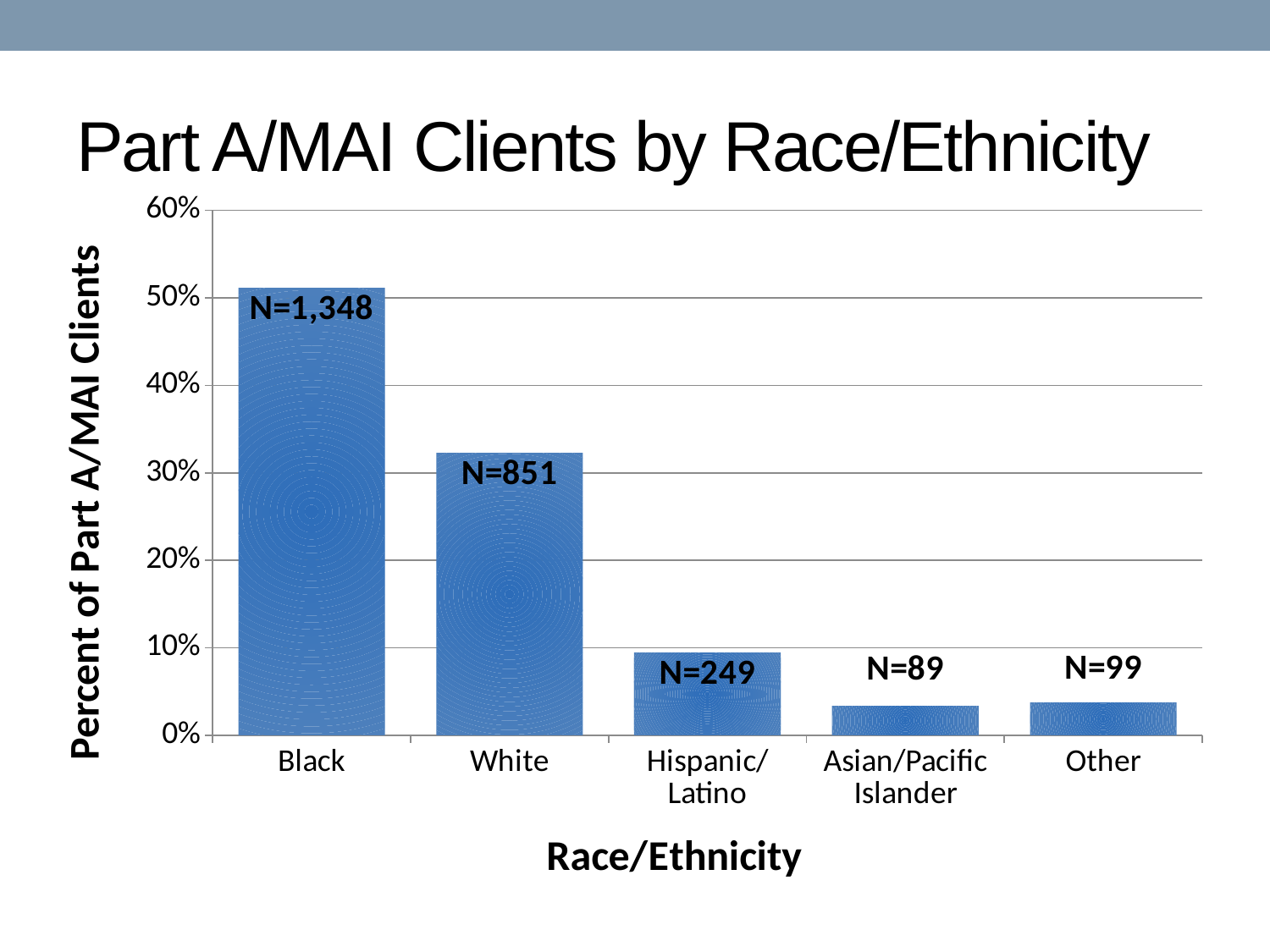
What is the N value printed for Hispanic/Latino clients? N=249 How many more clients are in the Black category than the White category, based on the printed N values? 497 What is the N value printed on the bar for White clients? N=851 Which category has the smallest N value printed on the chart? Asian/Pacific Islander Which race/ethnicity category has the highest percent of Part A/MAI clients? Black What is the N value printed on the bar for Black clients? N=1,348 Is the percent of Part A/MAI clients for White greater or less than 30%? greater What is the N value printed for Asian/Pacific Islander clients? N=89 What is the N value printed for the Other category? N=99 How many race/ethnicity categories are shown on the x axis? 5 What kind of chart is shown on the slide? bar chart Is the percent of Part A/MAI clients for Hispanic/Latino greater or less than 10%? less